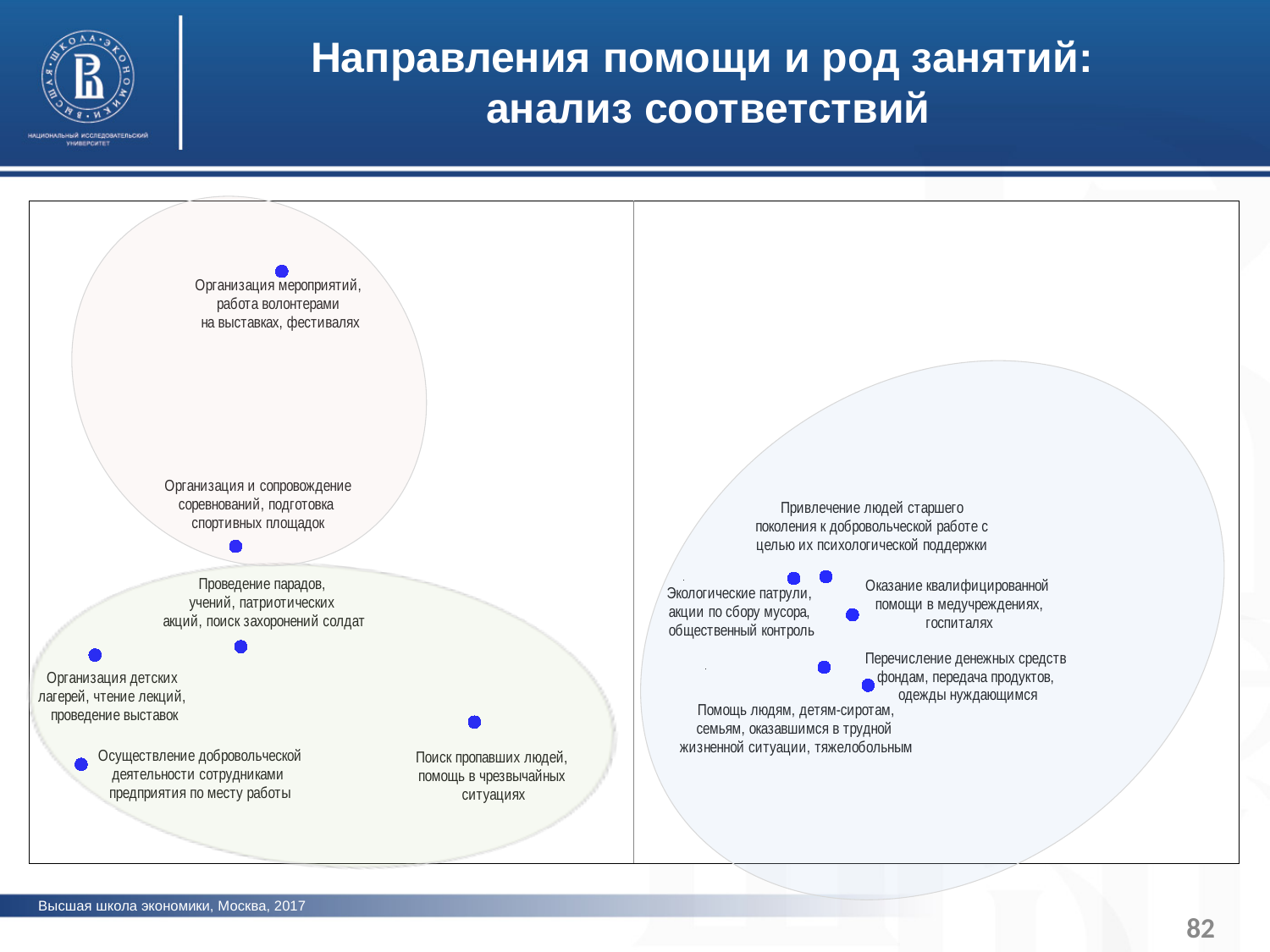
How many labelled points lie inside the top-left ellipse of the chart? 2 How many labelled points lie inside the ellipse on the right half of the chart? 5 Which point is plotted higher: 'Организация мероприятий, работа волонтерами на выставках, фестивалях' or 'Поиск пропавших людей, помощь в чрезвычайных ситуациях'? Организация мероприятий, работа волонтерами на выставках, фестивалях Which point is plotted lower: 'Осуществление добровольческой деятельности сотрудниками предприятия по месту работы' or 'Организация и сопровождение соревнований, подготовка спортивных площадок'? Осуществление добровольческой деятельности сотрудниками предприятия по месту работы What is the title of the slide containing the chart? Направления помощи и род занятий: анализ соответствий Which labelled point is positioned highest on the chart? Организация мероприятий, работа волонтерами на выставках, фестивалях How many ellipses (groups) are drawn around the points on the chart? 3 What kind of chart is shown on the slide? scatter chart Which labelled point is positioned furthest to the left on the chart? Осуществление добровольческой деятельности сотрудниками предприятия по месту работы How many labelled points are plotted on the chart? 11 Which point is plotted further to the right: 'Экологические патрули, акции по сбору мусора, общественный контроль' or 'Проведение парадов, учений, патриотических акций, поиск захоронений солдат'? Экологические патрули, акции по сбору мусора, общественный контроль Which labelled point is positioned furthest to the right on the chart? Перечисление денежных средств фондам, передача продуктов, одежды нуждающимся